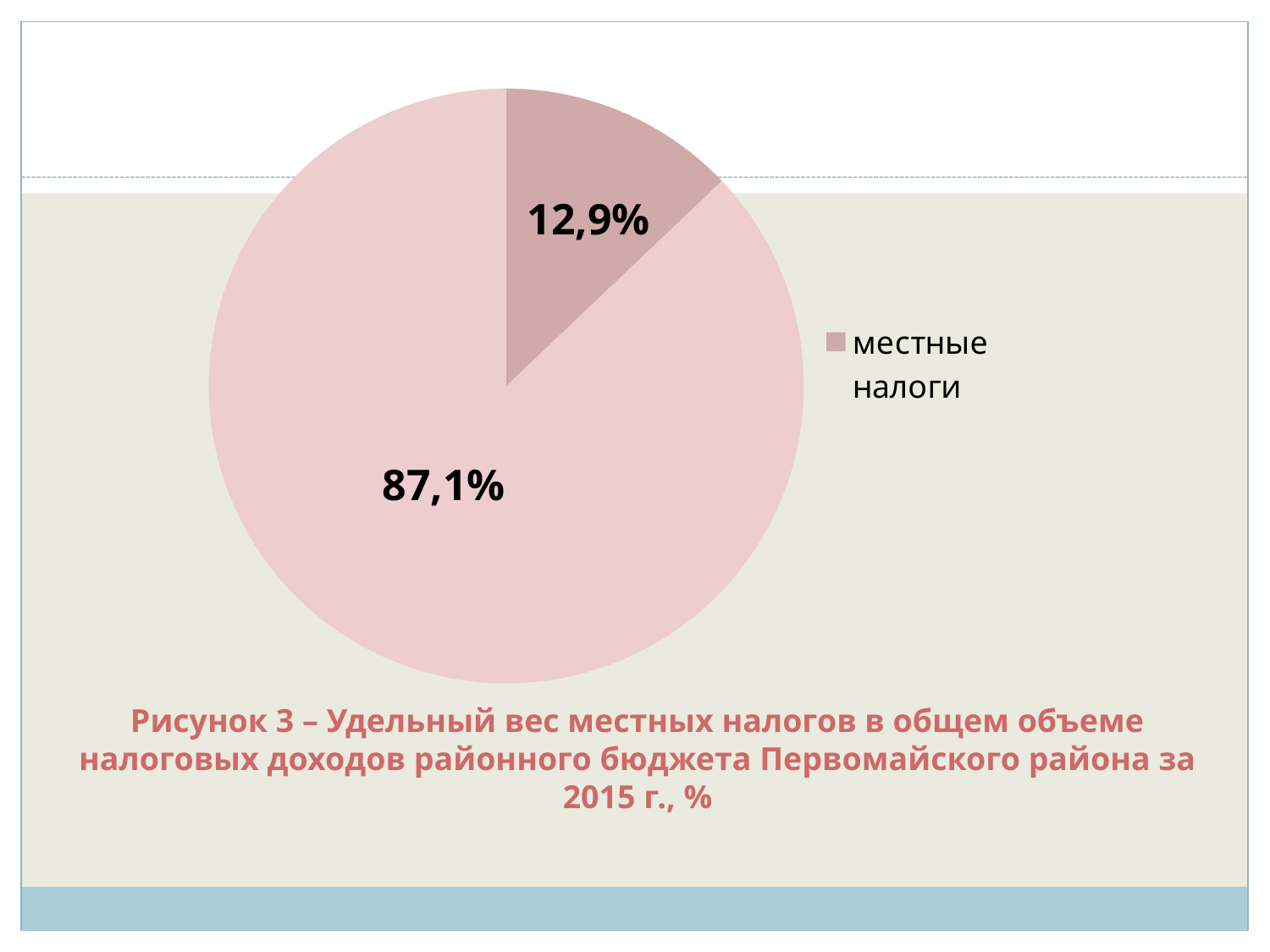
Is the slice for местные налоги larger or smaller than the other slice? smaller What kind of chart is shown on the slide? pie chart What is the value printed on the larger slice of the pie? 87,1% What is the difference in percentage points between the two slices of the pie? 74,2 Is the share for местные налоги greater or less than 50%? less What share of the pie is labelled for местные налоги? 12,9% How many entries does the legend list? 1 How many slices does the pie chart have? 2 Which slice is the largest in the pie chart? 87,1% Which slice is the smallest in the pie chart? местные налоги (12,9%) What is the legend entry shown next to the pie chart? местные налоги What figure number is given in the caption below the chart? Рисунок 3